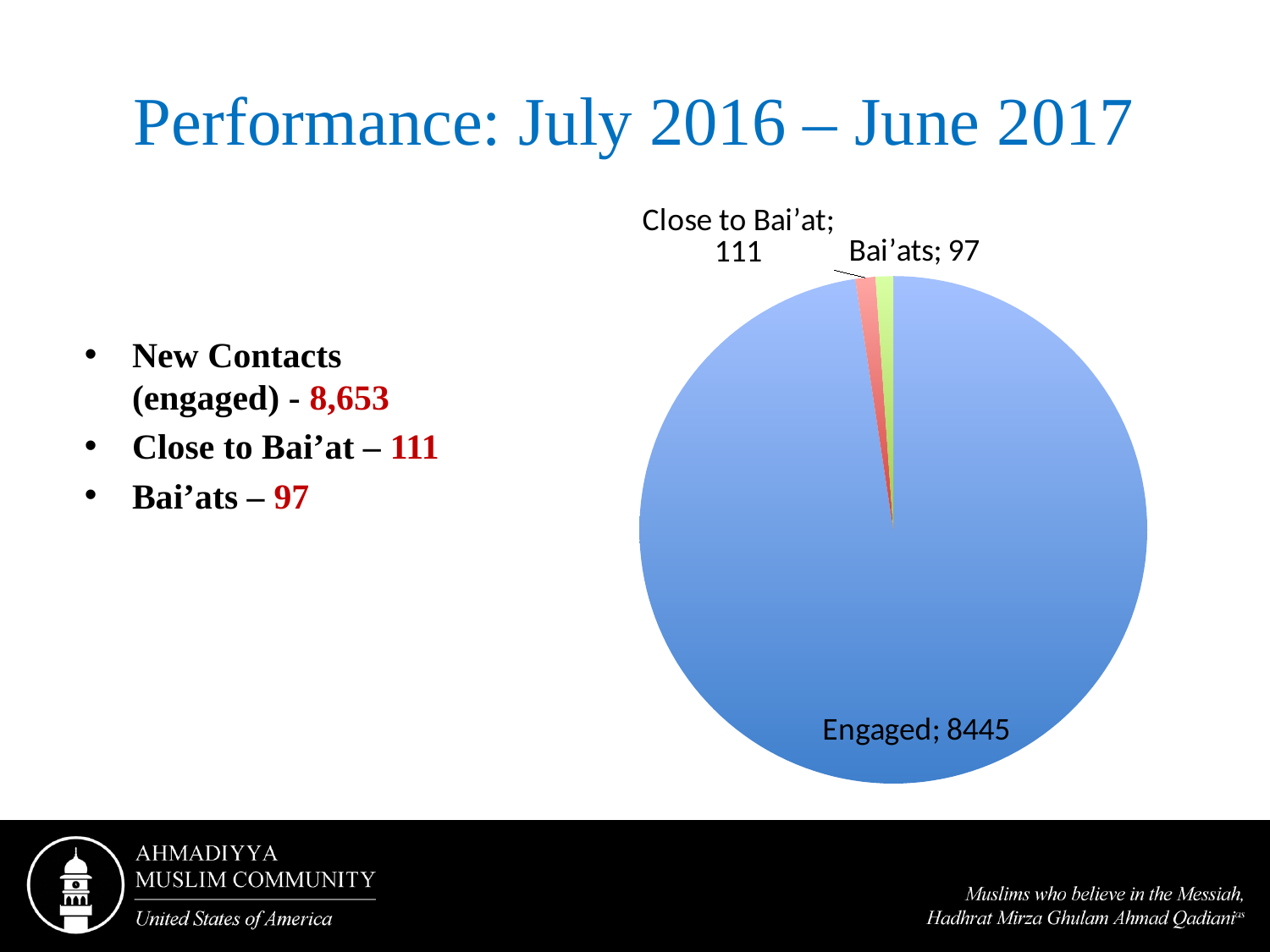
What is the value of the Engaged slice in the pie chart? 8445 How many slices does the pie chart have? 3 Which is larger in the pie chart, Close to Bai'at or Bai'ats? Close to Bai'at Which slice of the pie chart is the largest? Engaged What is the value of the Close to Bai'at slice in the pie chart? 111 What is the difference between the Close to Bai'at value and the Bai'ats value in the pie chart? 14 Which slice of the pie chart is the smallest? Bai'ats What is the total of all three slices in the pie chart? 8653 What is the value of the Bai'ats slice in the pie chart? 97 What kind of chart is shown on the slide? pie chart What colour is the Engaged slice in the pie chart? blue